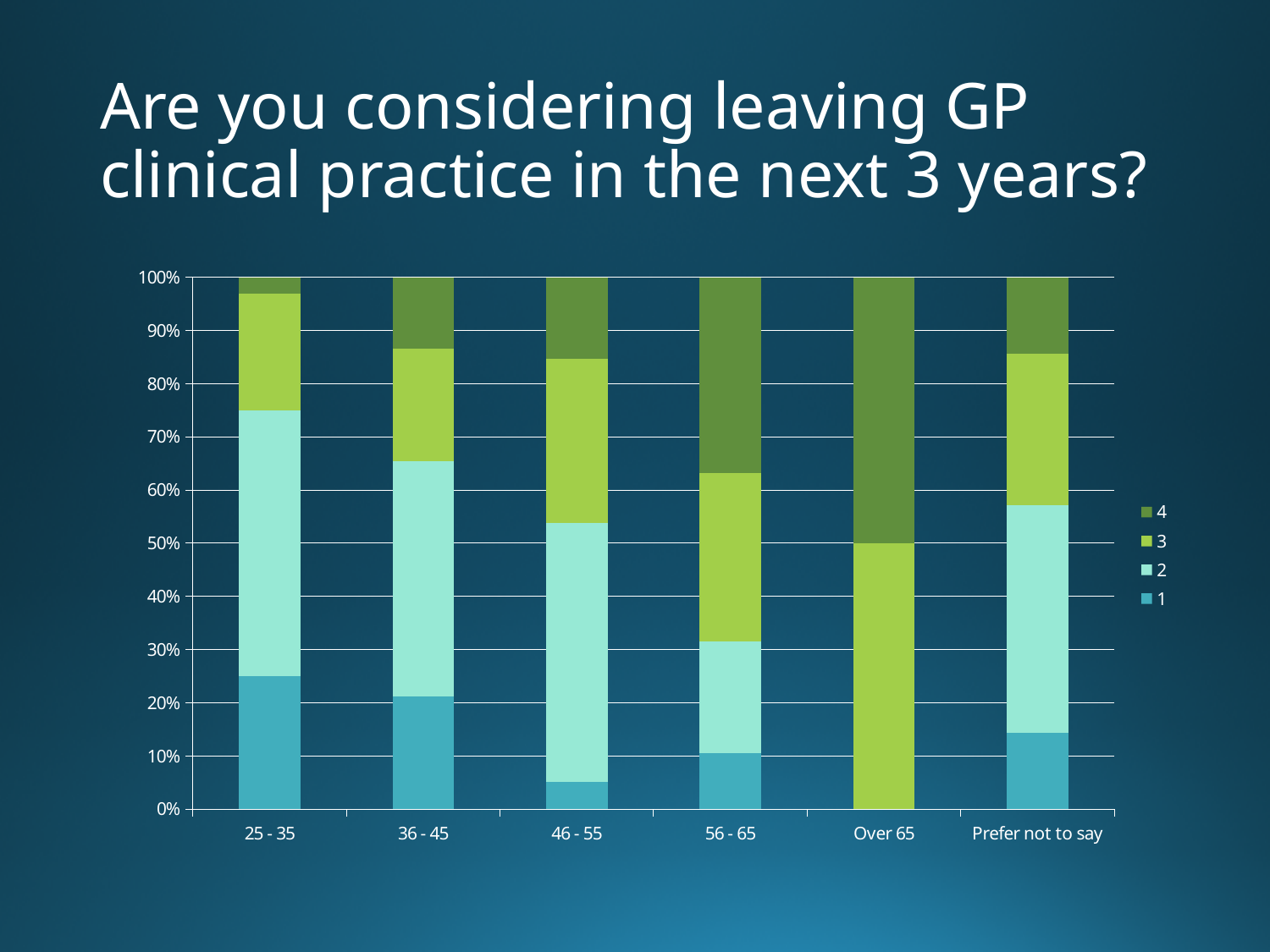
Which category has the largest share for series 1? 25 - 35 What kind of chart is shown on the slide? Stacked bar chart Does the share for series 4 rise or fall across the age groups from 25 - 35 to Over 65? rises Which is larger: the share for series 1 in 25 - 35 or in 46 - 55? 25 - 35 Is the share for series 1 in the 46 - 55 category greater or less than 10%? less Which category shows no segment for series 1 or series 2? Over 65 Is the share for series 4 in the 56 - 65 category greater or less than 30%? greater Which category has the largest share for series 4? Over 65 How many series does the legend list? 4 Is the share for series 1 in the 25 - 35 category greater or less than 20%? greater What is the title of the slide above the chart? Are you considering leaving GP clinical practice in the next 3 years? How many categories are shown on the x axis? 6